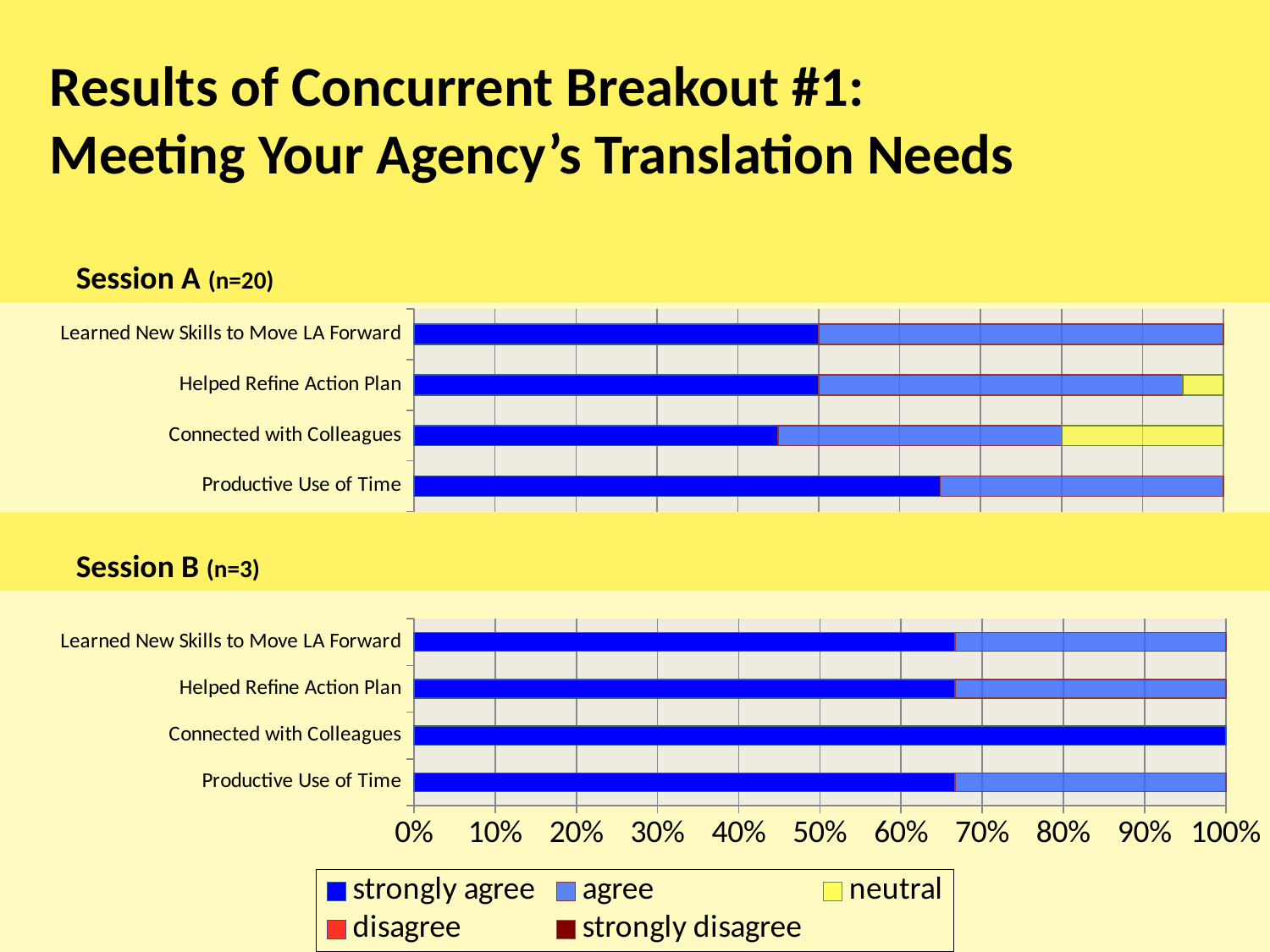
In the Session B (n=3) chart, is the 'strongly agree' share for Learned New Skills to Move LA Forward greater or less than 60%? greater How many series does the legend list? 5 In the Session B (n=3) chart, what is the 'strongly agree' share for Connected with Colleagues? 100% In the Session A (n=20) chart, is the 'strongly agree' share for Productive Use of Time greater or less than 60%? greater In the Session A (n=20) chart, is the 'strongly agree' share for Connected with Colleagues greater or less than 50%? less In the Session A (n=20) chart, which category has the smallest 'strongly agree' share? Connected with Colleagues In the Session B (n=3) chart, which category has the largest 'strongly agree' share? Connected with Colleagues In the Session A (n=20) chart, which category has the largest 'strongly agree' share? Productive Use of Time What kind of chart is used for Session A (n=20)? stacked bar chart Which colour represents 'neutral' in the legend? yellow How many categories are shown on the Session B (n=3) chart? 4 In the Session A (n=20) chart, which category has the larger 'neutral' share: Connected with Colleagues or Helped Refine Action Plan? Connected with Colleagues